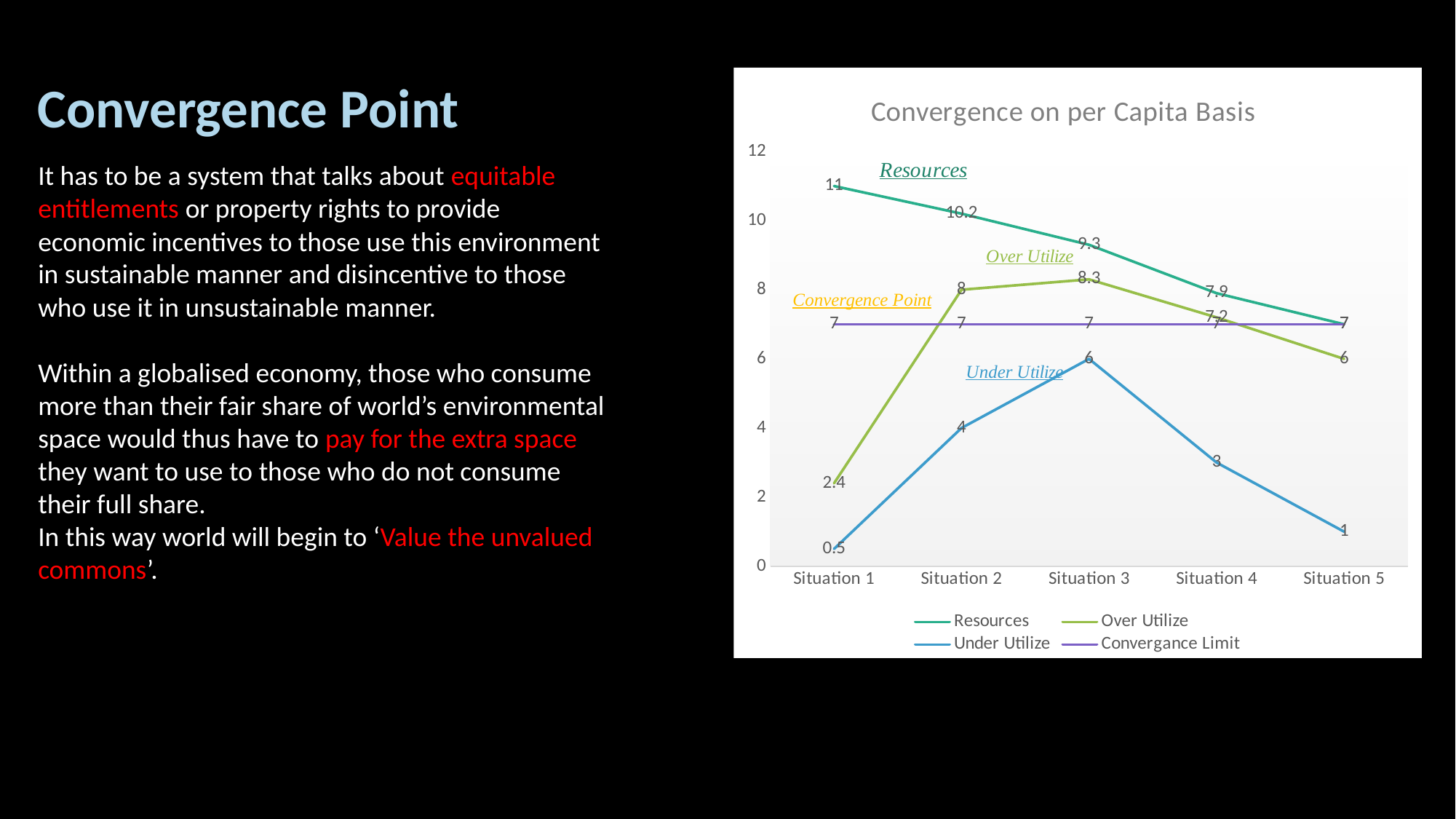
Which is larger at Situation 4: Over Utilize or Under Utilize? Over Utilize What kind of chart is shown? Line chart What is the value of the Convergance Limit at Situation 2? 7 What is the value of Resources at Situation 1? 11 At which situation is Over Utilize lowest? Situation 1 How many situations are shown on the x axis? 5 What is the value of Under Utilize at Situation 5? 1 What is the difference between Resources and Over Utilize at Situation 2? 2.2 What is the value of Over Utilize at Situation 3? 8.3 Does the Resources series rise or fall from Situation 1 to Situation 5? Fall At which situation is Under Utilize highest? Situation 3 How many series does the legend list? 4